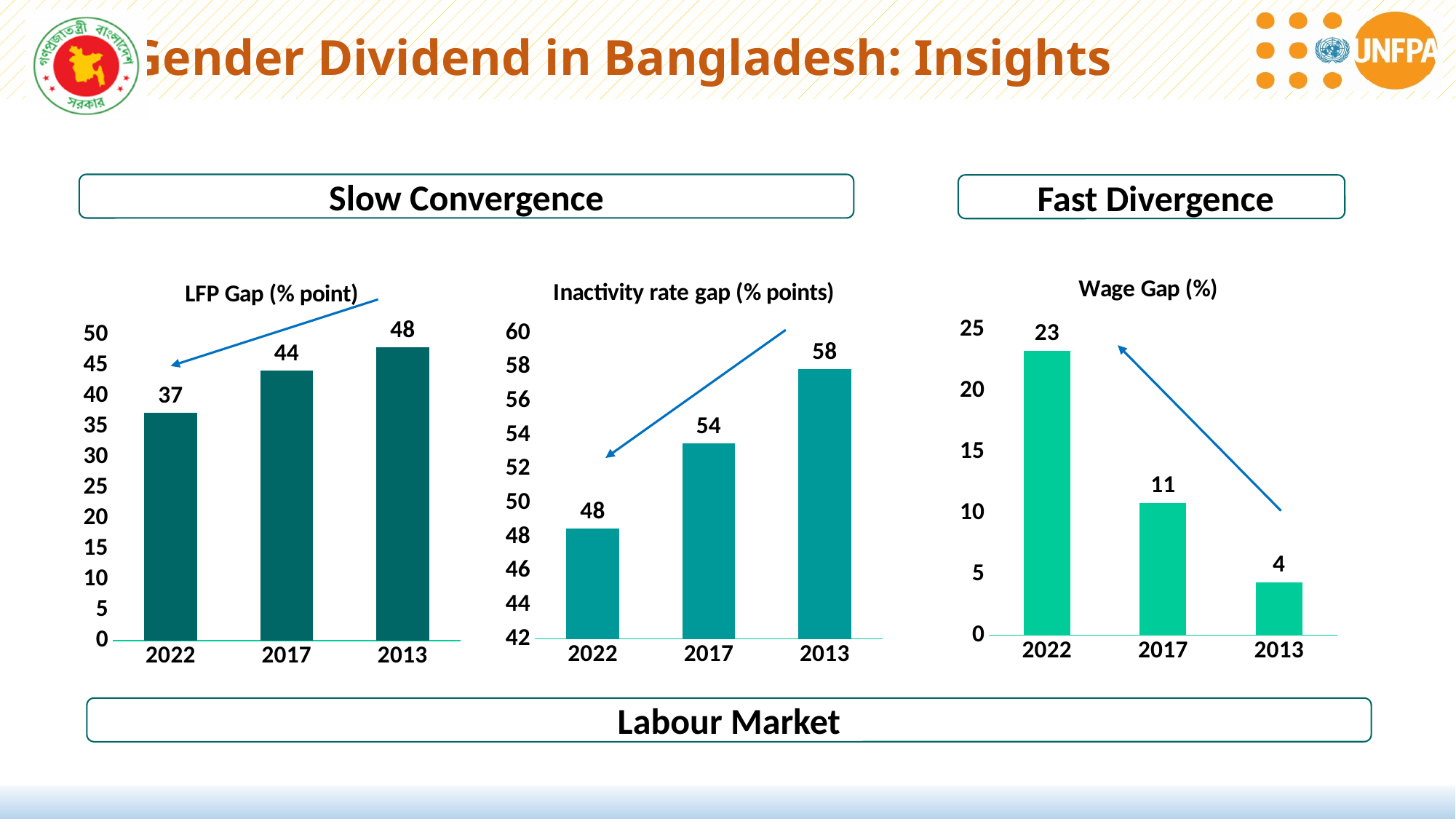
In the LFP Gap (% point) chart, which year has the highest value? 2013 In the LFP Gap (% point) chart, what is the difference between the 2013 and 2022 values? 11 In the Wage Gap (%) chart, do the values rise or fall from 2022 to 2013 along the x axis? fall In the Inactivity rate gap (% points) chart, which year has the lowest value? 2022 In the Wage Gap (%) chart, what is the difference between the 2022 and 2017 values? 12 What kind of chart is the Wage Gap (%) chart? bar chart In the Inactivity rate gap (% points) chart, is the value for 2013 greater or less than 56? greater In the Wage Gap (%) chart, which year has the highest value? 2022 In the LFP Gap (% point) chart, what is the value for 2022? 37 In the Wage Gap (%) chart, what is the value for 2013? 4 How many bars are in the LFP Gap (% point) chart? 3 In the Inactivity rate gap (% points) chart, what is the value for 2017? 54